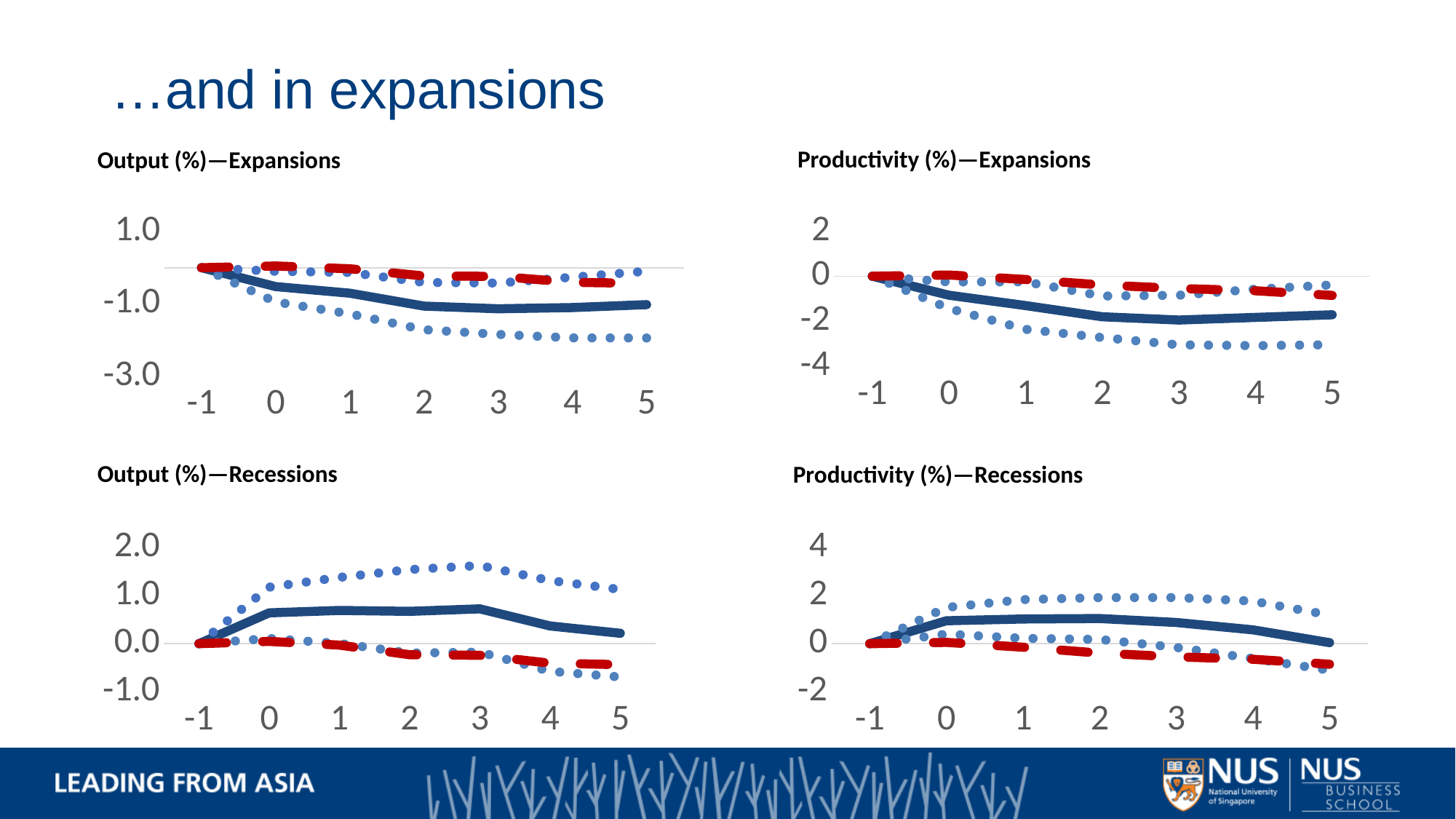
In the "Output (%)—Recessions" chart, is the upper dotted line at x = 3 greater or less than 1.0? greater How many points are labelled on the x axis of the "Productivity (%)—Recessions" chart? 7 In the "Productivity (%)—Expansions" chart, is the solid line at x = 0 greater or less than -2? greater What kind of chart is "Output (%)—Expansions"? line chart In the "Output (%)—Recessions" chart, does the solid line rise or fall from 3 to 5? fall How many lines are plotted in the "Output (%)—Recessions" chart? 4 How many charts are shown on the slide? 4 In the "Productivity (%)—Expansions" chart, does the solid line rise or fall from -1 to 3? fall In the "Output (%)—Expansions" chart, does the solid line rise or fall from -1 to 5? fall What is the title of the chart in the top-right position of the slide? Productivity (%)—Expansions In the "Output (%)—Recessions" chart, at which x value does the solid line reach its highest point? 3 In the "Productivity (%)—Recessions" chart, is the solid line at x = 2 greater or less than 2? less